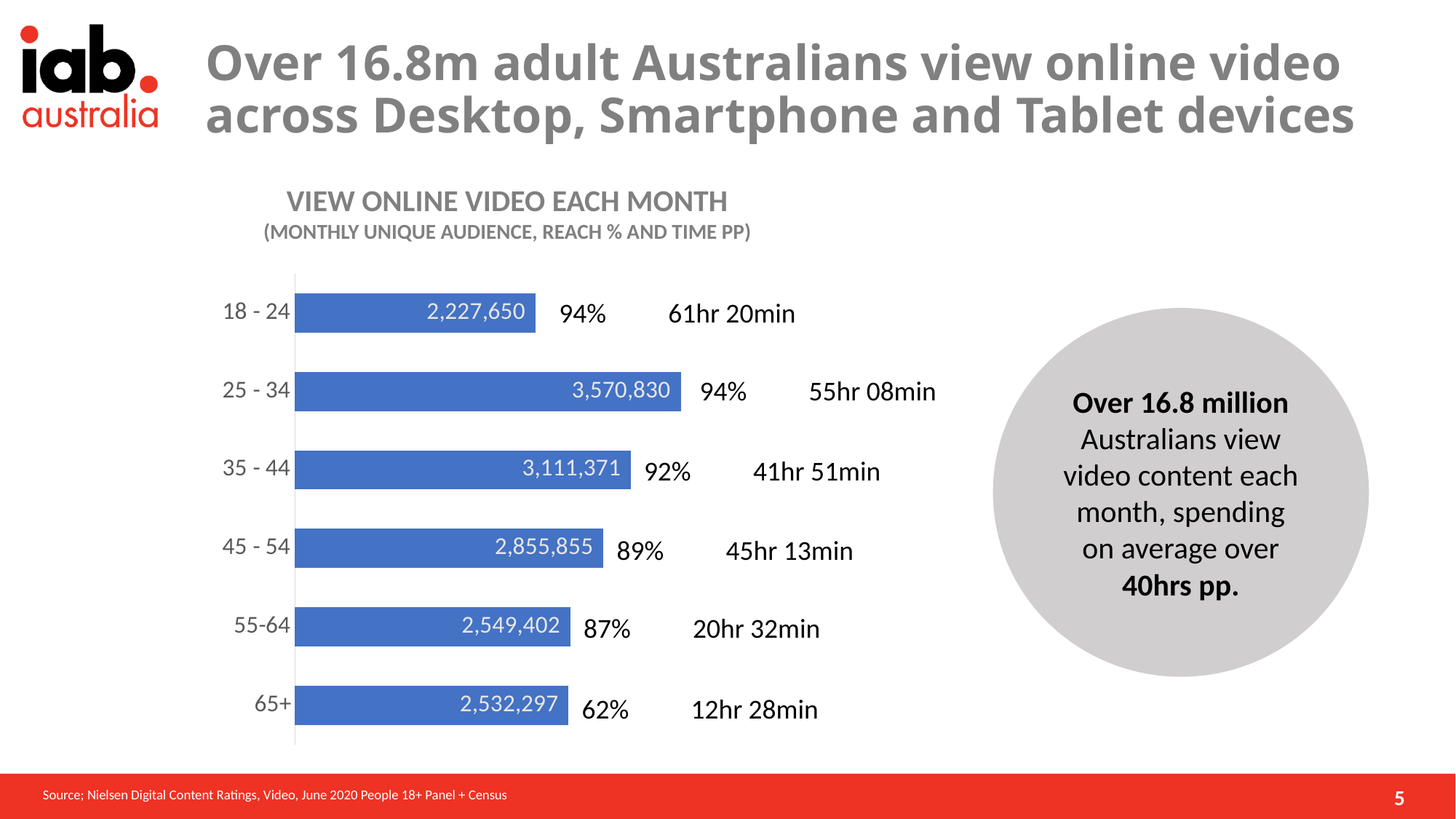
What is the title of the chart? VIEW ONLINE VIDEO EACH MONTH What is the monthly unique audience for the 65+ age group? 2,532,297 Which age group has the highest monthly unique audience? 25 - 34 Which age group has the lowest reach percentage? 65+ What is the difference in monthly unique audience between the 25 - 34 and 18 - 24 age groups? 1,343,180 What is the monthly unique audience for the 25 - 34 age group? 3,570,830 What time per person is shown for the 18 - 24 age group? 61hr 20min How many age groups are shown in the chart? 6 Which age group has a larger monthly unique audience, 35 - 44 or 45 - 54? 35 - 44 Which age group has the lowest monthly unique audience? 18 - 24 What kind of chart is shown on the slide? Bar chart What reach percentage is shown for the 45 - 54 age group? 89%